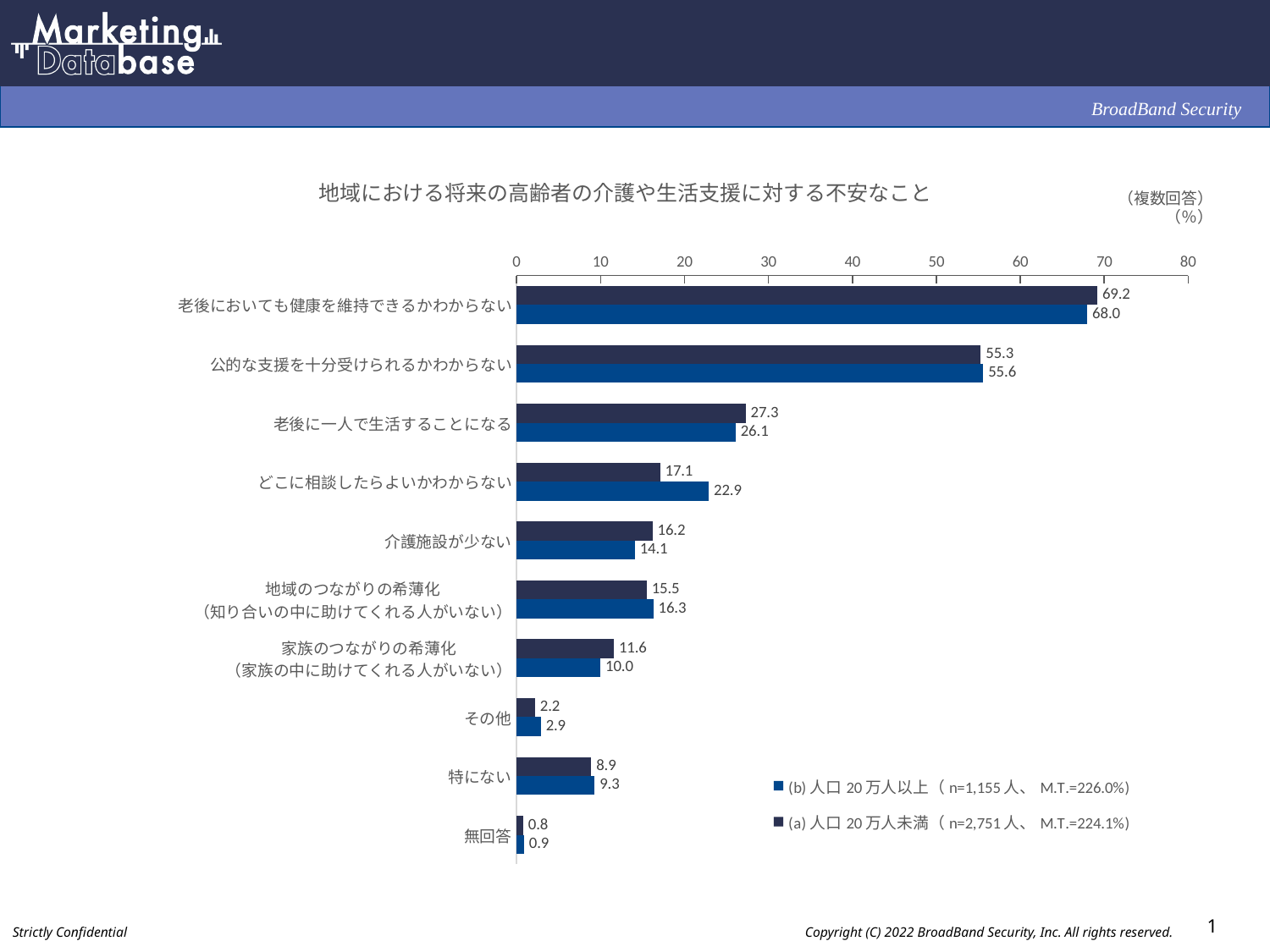
What is the value for 老後においても健康を維持できるかわからない in the (a) 人口20万人未満 series? 69.2 What type of chart is shown on the slide? bar chart What is the value for 介護施設が少ない in the (a) 人口20万人未満 series? 16.2 How many series does the legend list? 2 For 老後に一人で生活することになる, which series has the larger value: (a) 人口20万人未満 or (b) 人口20万人以上? (a) 人口20万人未満 What is the value for どこに相談したらよいかわからない in the (b) 人口20万人以上 series? 22.9 Which category has the lowest value in the (a) 人口20万人未満 series? 無回答 Which category has the highest value in the (b) 人口20万人以上 series? 老後においても健康を維持できるかわからない What is the difference between the (b) 人口20万人以上 and (a) 人口20万人未満 values for どこに相談したらよいかわからない? 5.8 What is the sample size (n) shown in the legend for the (b) 人口20万人以上 series? 1,155人 How many categories are plotted on the chart? 10 What is the title of the chart? 地域における将来の高齢者の介護や生活支援に対する不安なこと